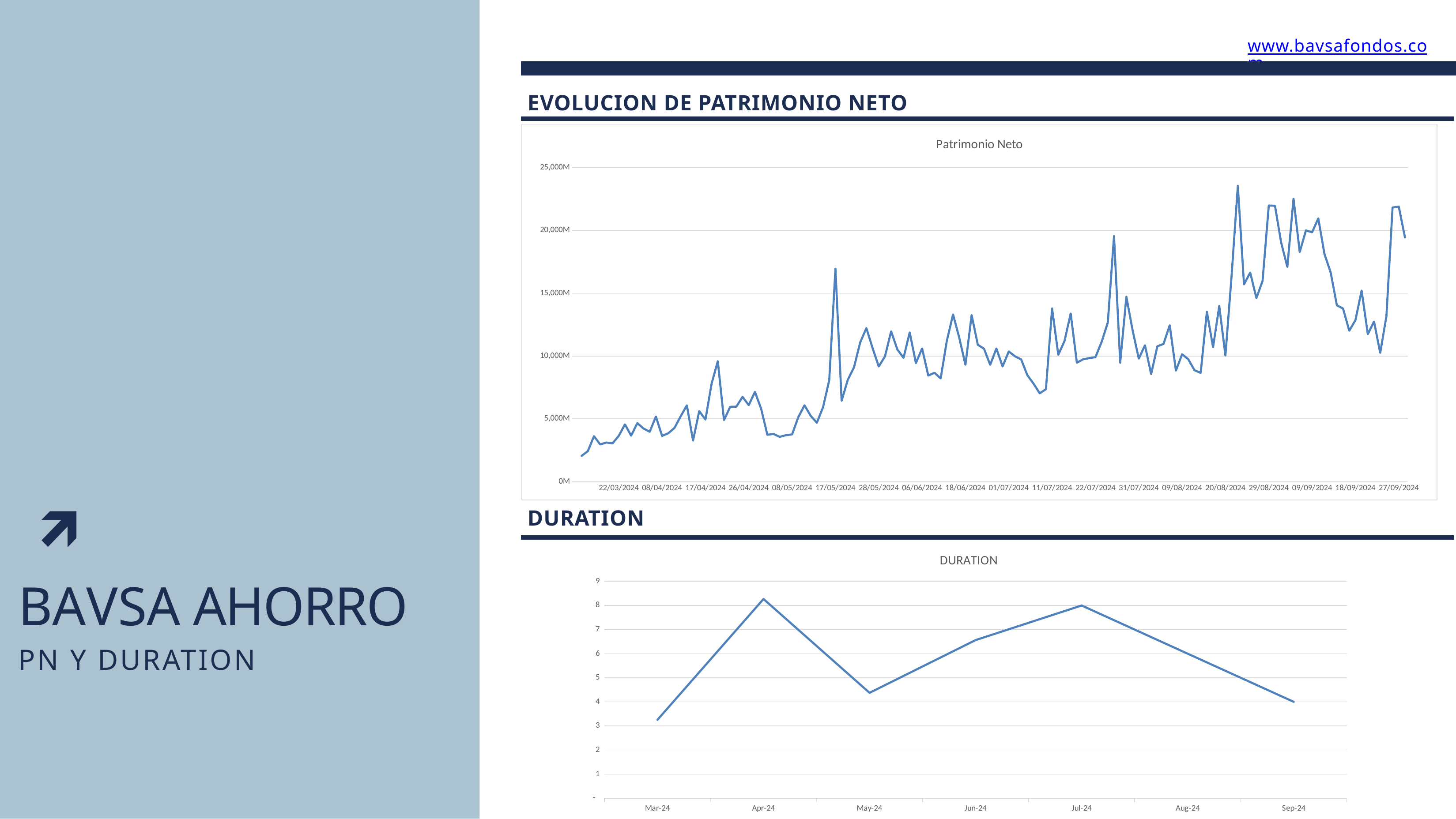
In the DURATION chart, is the value for Jun-24 greater or less than 6? greater In the DURATION chart, what is the duration for Jul-24? 8 What kind of chart is the DURATION chart at the bottom of the slide? line chart In the Patrimonio Neto chart, does the patrimonio neto generally rise or fall from March 2024 to September 2024? rise In the DURATION chart, what is the duration for Sep-24? 4 In the DURATION chart, which is larger, the duration for Apr-24 or for Aug-24? Apr-24 In the DURATION chart, which month has the highest duration? Apr-24 In the Patrimonio Neto chart, is the value for 22/03/2024 greater or less than 5,000M? less What is the title of the top chart on the slide? Patrimonio Neto In the DURATION chart, is the value for May-24 greater or less than 5? less In the DURATION chart, how many months are plotted on the x axis? 7 In the DURATION chart, which month has the lowest duration? Mar-24